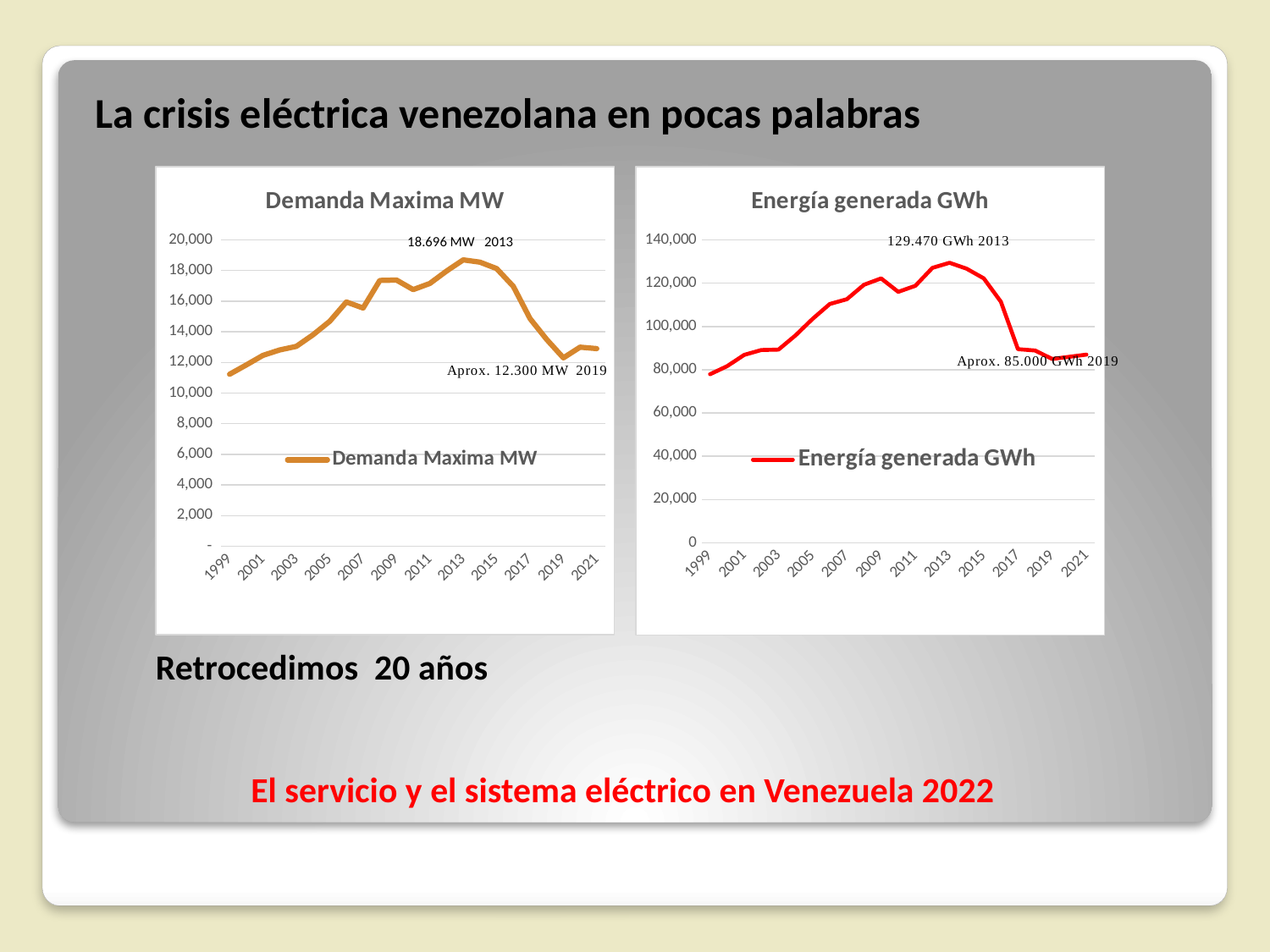
In the 'Energía generada GWh' chart, what is the peak value labelled for 2013? 129.470 GWh In the 'Energía generada GWh' chart, do the values rise or fall between 2013 and 2019? fall In the 'Demanda Maxima MW' chart, which year has the highest value? 2013 What kind of chart is the 'Energía generada GWh' chart on the right? line chart In the 'Demanda Maxima MW' chart, is the value for 2013 greater or less than 18,000? greater In the 'Energía generada GWh' chart, which year has the highest value? 2013 In the 'Demanda Maxima MW' chart, is the value for 2019 greater or less than 14,000? less In the 'Energía generada GWh' chart, is the value for 2019 greater or less than 100,000? less What kind of chart is the 'Demanda Maxima MW' chart on the left? line chart In the 'Demanda Maxima MW' chart, what is the peak value labelled for 2013? 18.696 MW How many series does the legend of the 'Demanda Maxima MW' chart list? 1 What colour is the line in the 'Energía generada GWh' chart? red